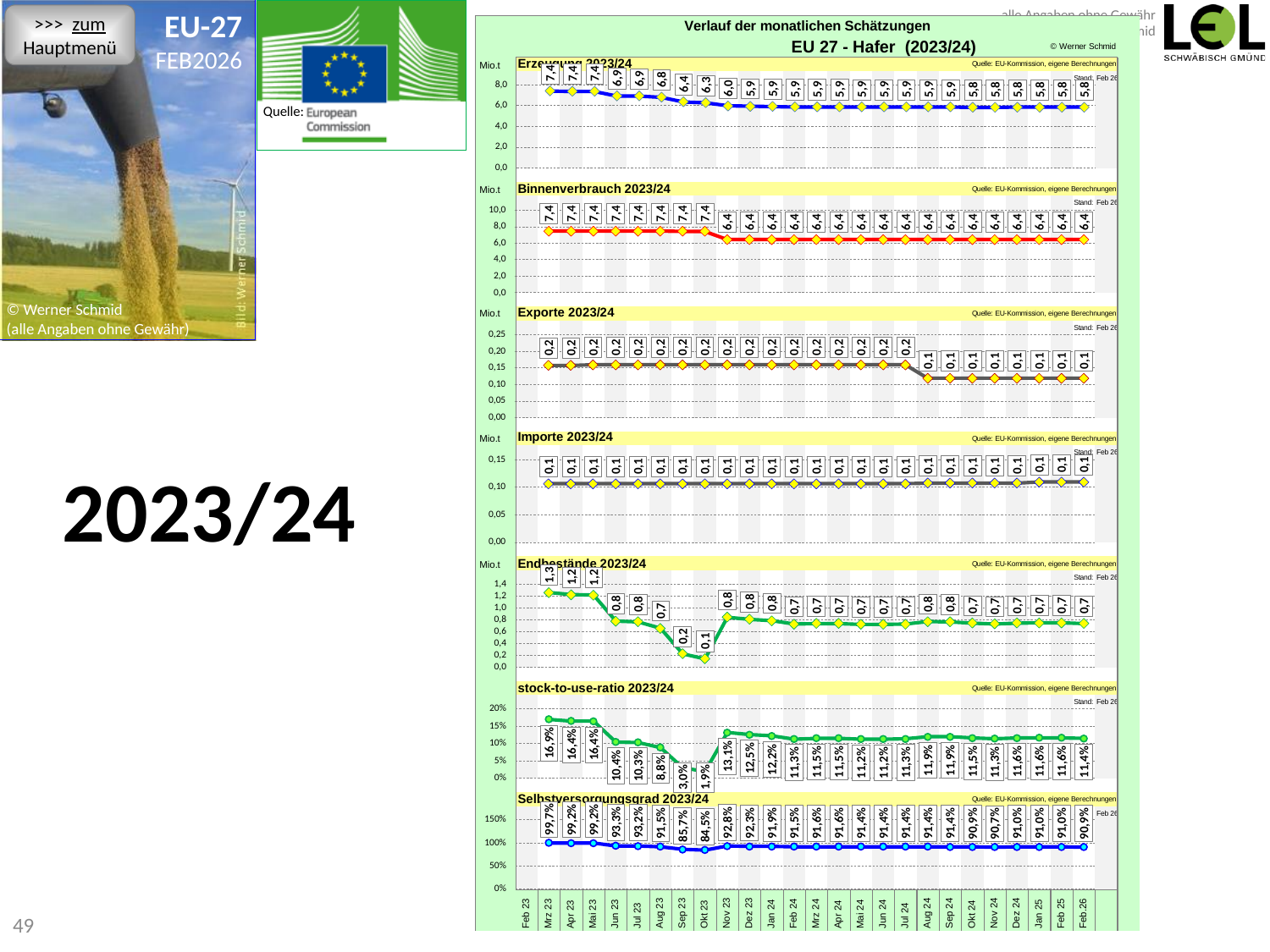
In the 'Erzeugung 2023/24' chart, what is the value for Feb 23? 7,4 In the 'Endbestände 2023/24' chart, what is the lowest value shown? 0,1 What kind of chart is used for the 'Erzeugung 2023/24' panel? line chart In the 'stock-to-use-ratio 2023/24' chart, what is the value for Feb 26? 11,4% In the 'Binnenverbrauch 2023/24' chart, what is the value for Feb 26? 6,4 In the 'Selbstversorgungsgrad 2023/24' chart, what is the lowest value shown? 84,5% In the 'Erzeugung 2023/24' chart, do the values rise or fall from Feb 23 to Feb 26? fall In the 'Selbstversorgungsgrad 2023/24' chart, is the value for Feb 23 greater or less than 100%? less In the 'Erzeugung 2023/24' chart, what is the difference between the Feb 23 value and the Feb 26 value? 1,6 In the 'Exporte 2023/24' chart, what is the value for Feb 23? 0,2 In the 'Erzeugung 2023/24' chart, what is the value for Feb 26? 5,8 In the 'Endbestände 2023/24' chart, what is the highest value shown? 1,3